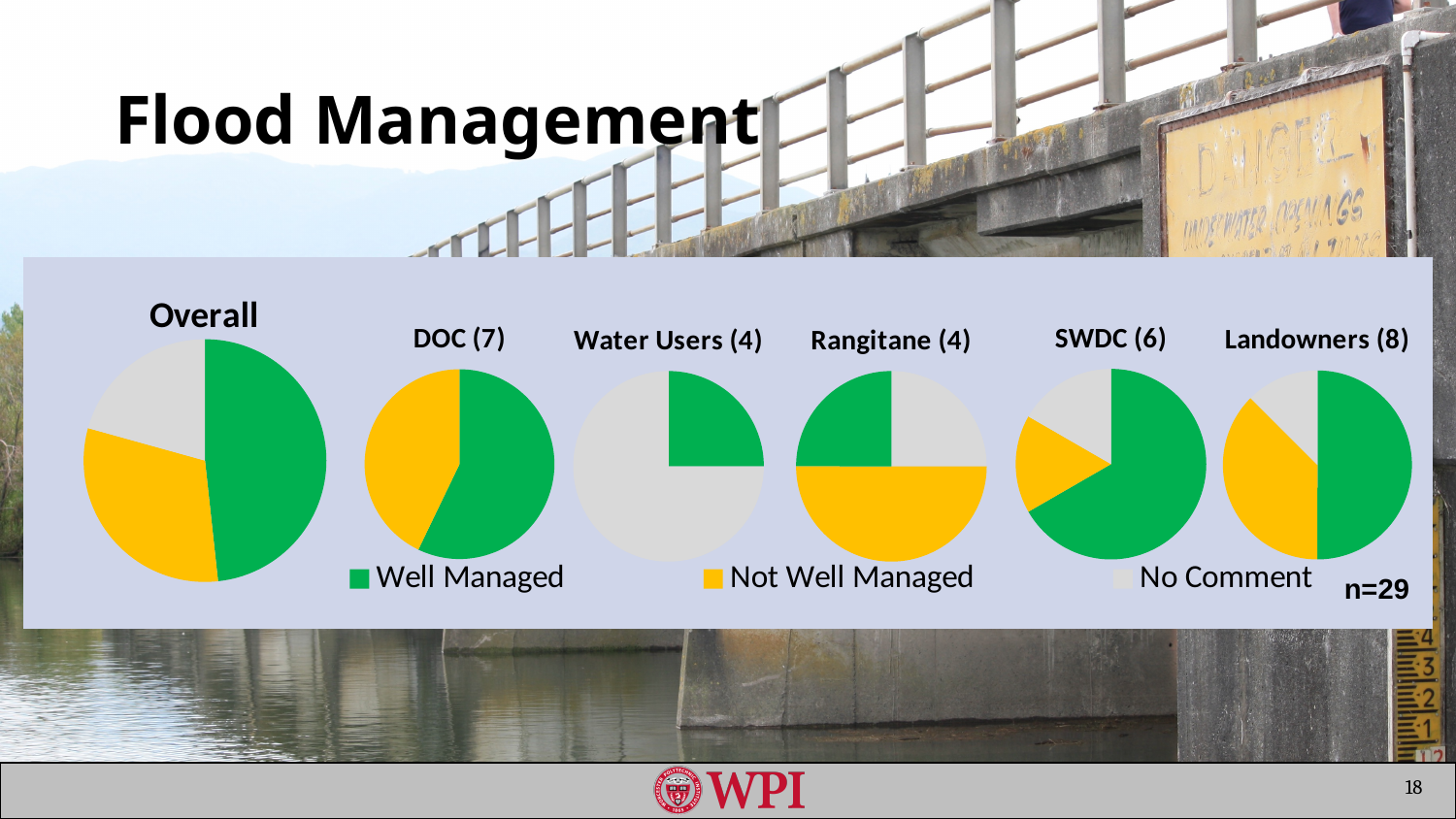
In the Overall pie chart, which category has the smallest slice? No Comment How many categories does the legend list? 3 In the Overall pie chart, which is larger: Well Managed or Not Well Managed? Well Managed In the Landowners (8) pie chart, which category has the smallest slice? No Comment Which pie chart has no No Comment slice? DOC (7) What kind of chart is used to show the Flood Management responses? Pie chart In the SWDC (6) pie chart, which is larger: Well Managed or No Comment? Well Managed In the Rangitane (4) pie chart, which category has the largest slice? Not Well Managed How many pie charts are shown on the slide? 6 What is the total sample size (n) shown on the slide? n=29 In the Water Users (4) pie chart, which category has the largest slice? No Comment In the Landowners (8) pie chart, which category has the largest slice? Well Managed